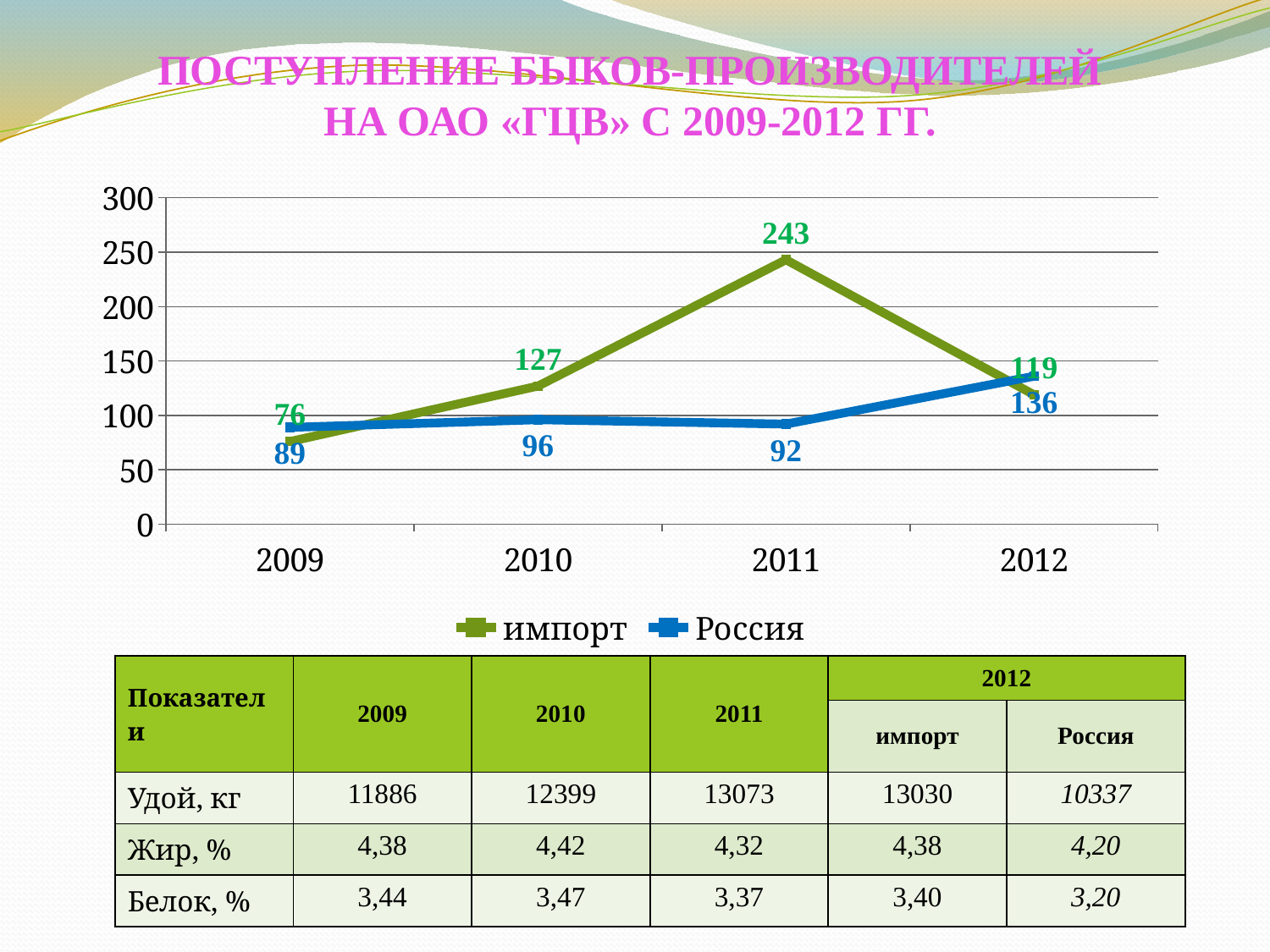
Does the импорт value rise or fall from 2011 to 2012? fall What type of chart is shown on the slide? line chart In which year is the Россия value lowest? 2009 What is the difference between импорт and Россия in 2011? 151 What is the value for Россия in 2012? 136 What is the value for Россия in 2010? 96 How many series does the chart legend list? 2 How many years are shown on the x axis of the chart? 4 In which year is the импорт value highest? 2011 What is the value for импорт in 2009? 76 Which series has the larger value in 2012, импорт or Россия? Россия What is the value for импорт in 2011? 243